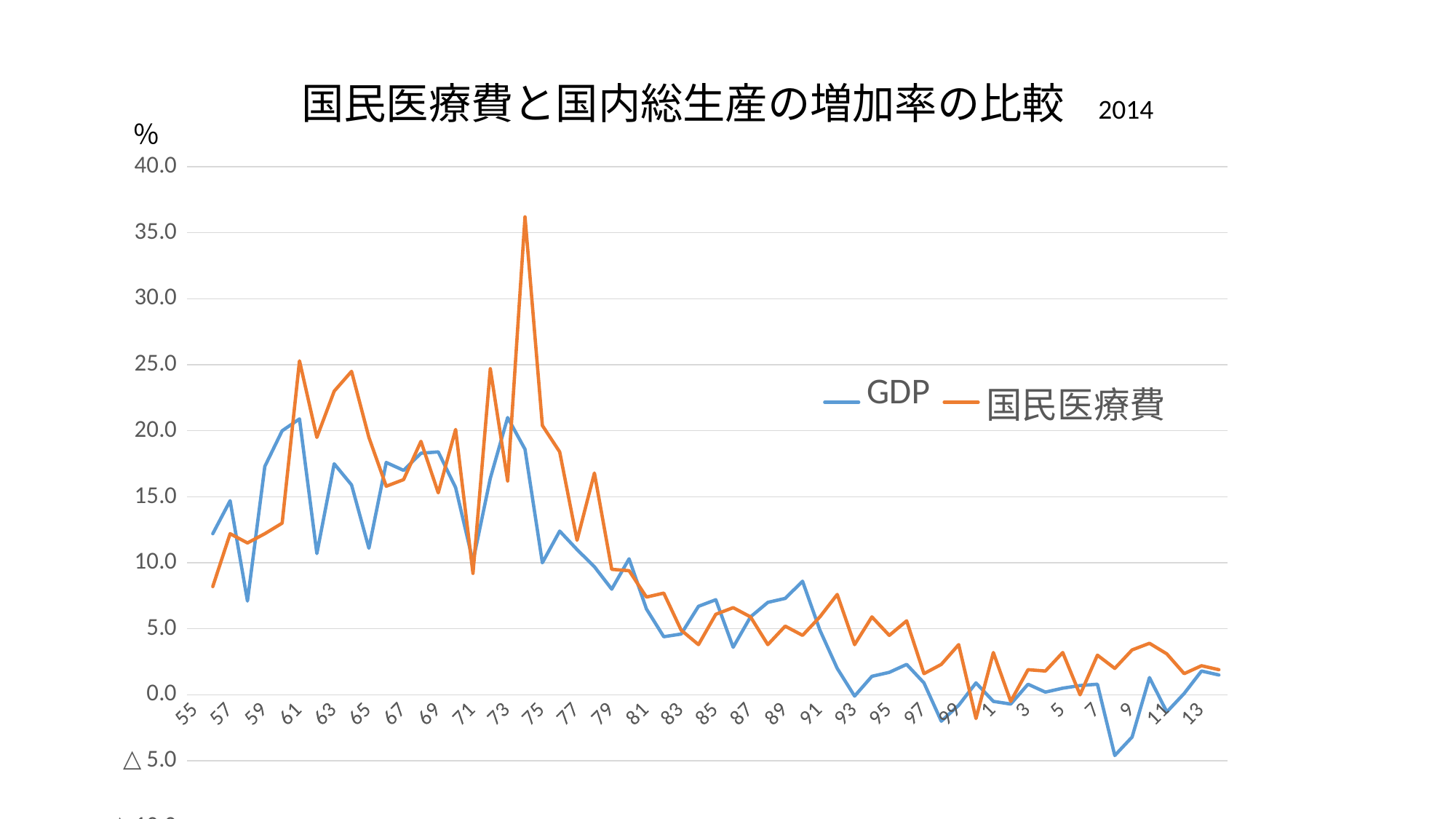
Overall, does the GDP line rise or fall from 55 to 13 along the x axis? fall Between which two labelled years does the 国民医療費 line reach its highest point? 73 and 75 Is the GDP value at 9 greater or less than 0.0? less Is the 国民医療費 value at 13 greater or less than 5.0? less What is the title of the chart? 国民医療費と国内総生産の増加率の比較 Is the GDP value at 59 greater or less than 10.0? greater What kind of chart is shown on the slide? line chart Which series reaches the highest value anywhere on the chart? 国民医療費 What are the two series named in the legend? GDP and 国民医療費 At 61, which series has the higher value, GDP or 国民医療費? 国民医療費 How many series does the legend list? 2